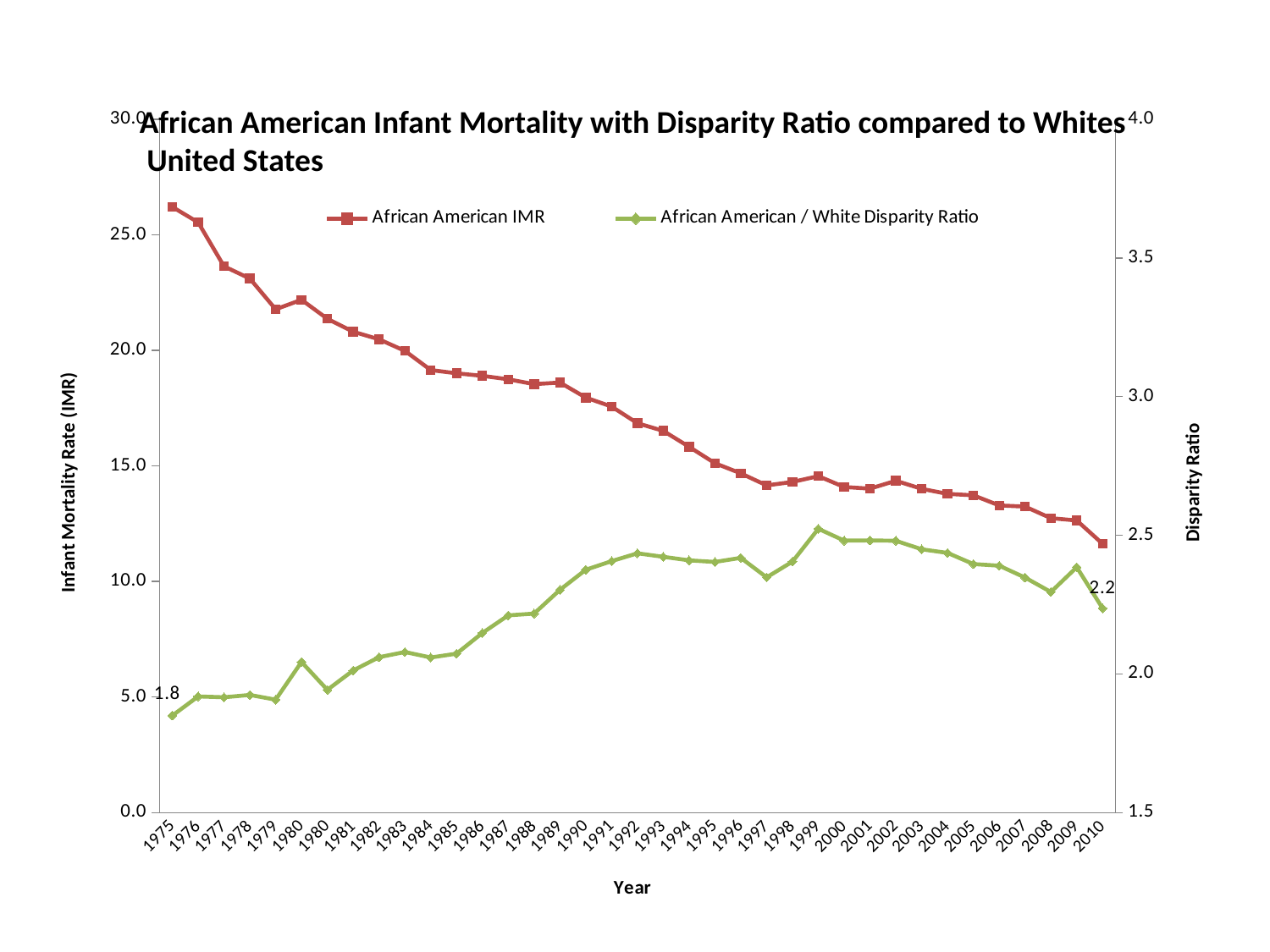
Is the African American IMR in 2010 greater or less than 15.0? less Is the African American IMR in 1975 greater or less than 25.0? greater Does the African American IMR rise or fall from 1975 to 2010? fall In which year is the African American IMR lowest? 2010 What kind of chart is shown on the slide? line chart In which year is the African American IMR highest? 1975 What is the African American / White Disparity Ratio in 2010? 2.2 What is the title of the right-hand vertical axis? Disparity Ratio Which year has the larger African American IMR, 1975 or 2010? 1975 How many series does the legend list? 2 What is the African American / White Disparity Ratio in 1975? 1.8 By how much did the African American / White Disparity Ratio change between 1975 and 2010? 0.4